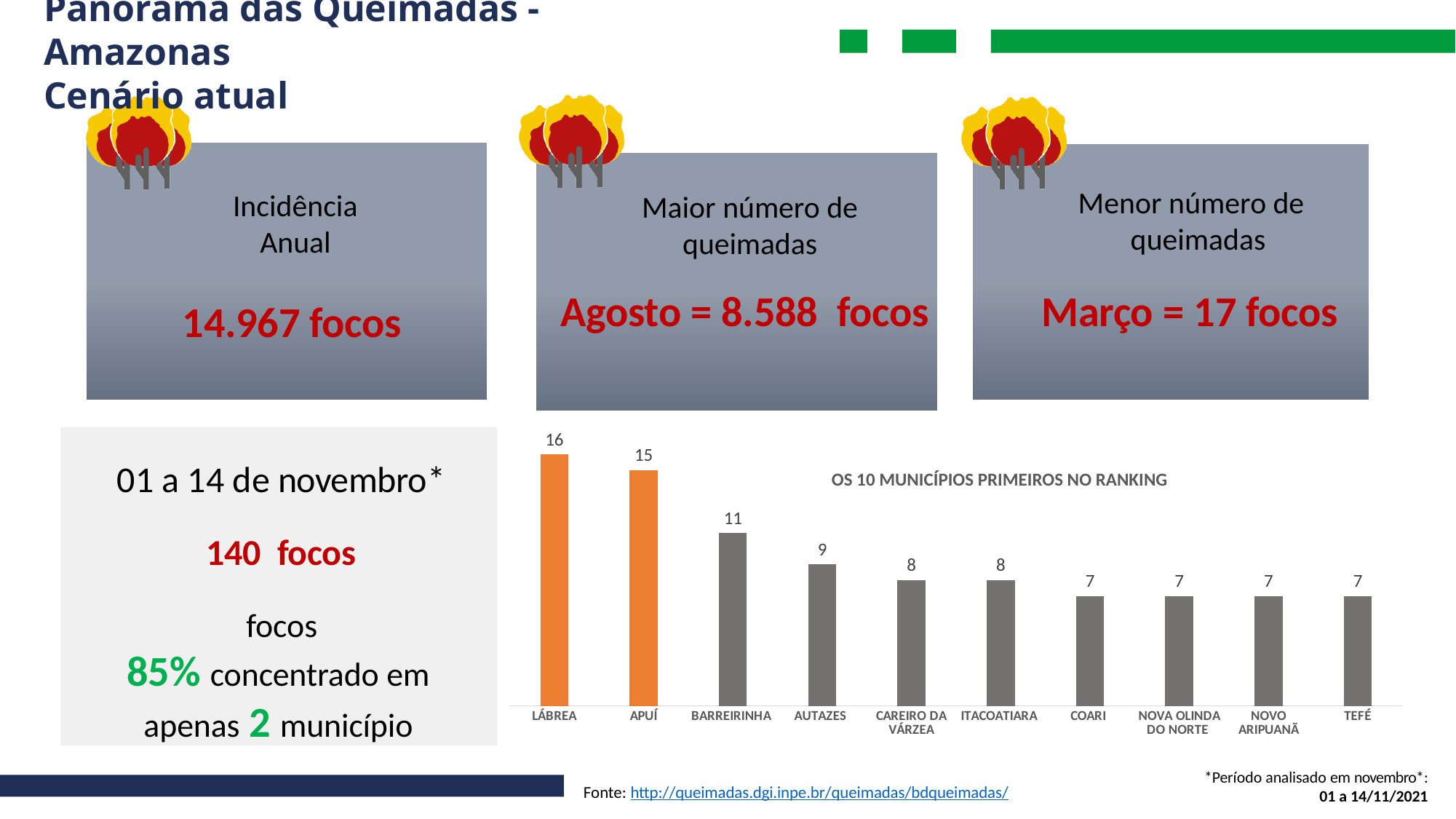
What is the value for LÁBREA? 16 How many municipalities are shown in the chart? 10 What is the value for BARREIRINHA? 11 What is the difference between the values for LÁBREA and BARREIRINHA? 5 What is the value for AUTAZES? 9 What is the title of the chart? OS 10 MUNICÍPIOS PRIMEIROS NO RANKING What is the value for APUÍ? 15 Which municipality has the highest value in the chart? LÁBREA What type of chart is shown on the slide? bar chart Which two bars in the chart are coloured orange? LÁBREA and APUÍ What is the value for ITACOATIARA? 8 Which is larger, the value for AUTAZES or the value for COARI? AUTAZES